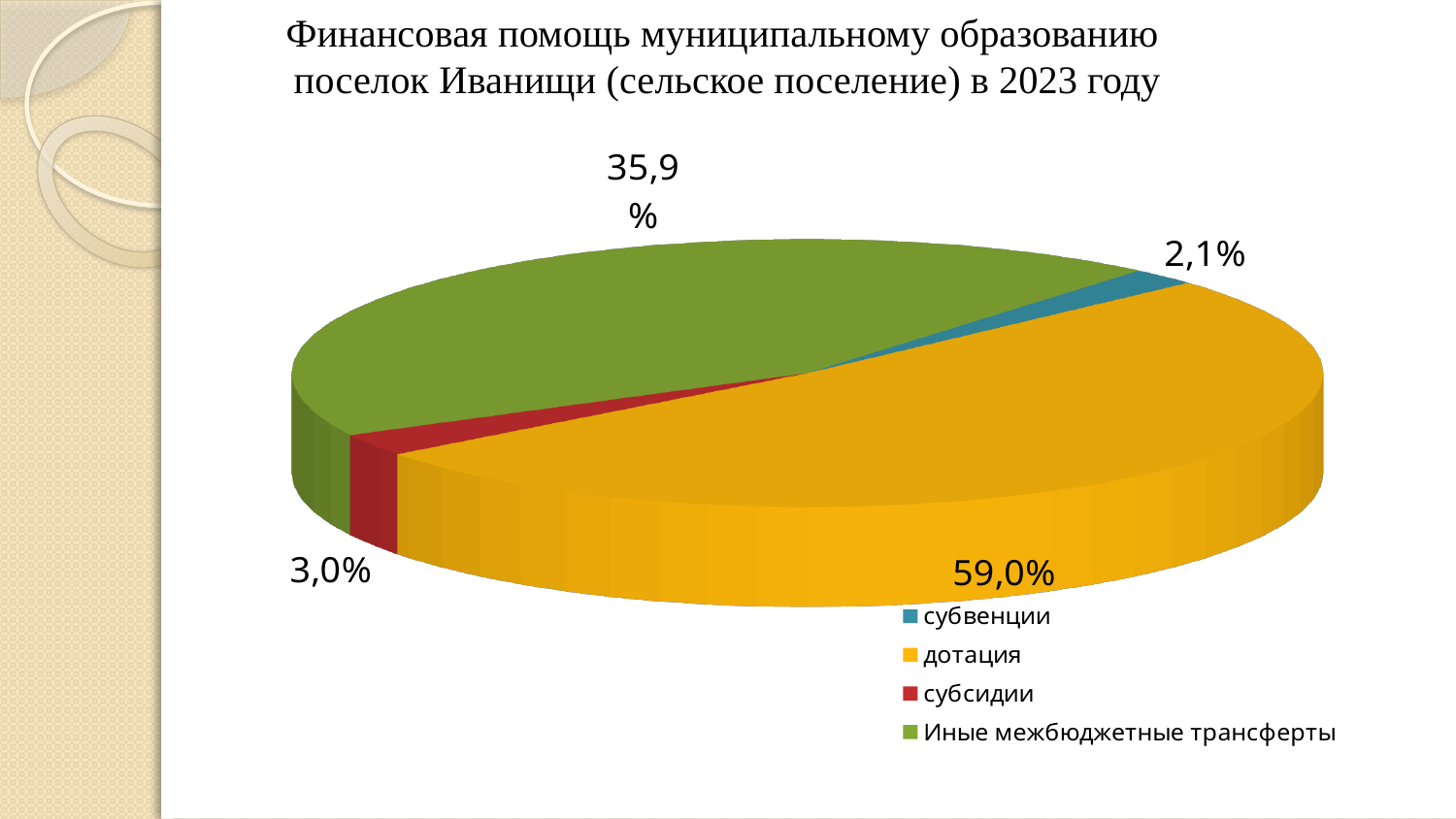
What share of the pie does субвенции have? 2,1% What share of the pie does Иные межбюджетные трансферты have? 35,9% What share of the pie does субсидии have? 3,0% What colour is the slice for дотация? yellow Which category has the smallest share of the pie? субвенции What year does the chart title refer to? 2023 What is the difference in percentage points between дотация and Иные межбюджетные трансферты? 23,1 What kind of chart is shown on the slide? pie chart Which category has the largest share of the pie? дотация Which is larger, the share for субсидии or the share for субвенции? субсидии How many categories does the legend list? 4 What share of the pie does дотация have? 59,0%